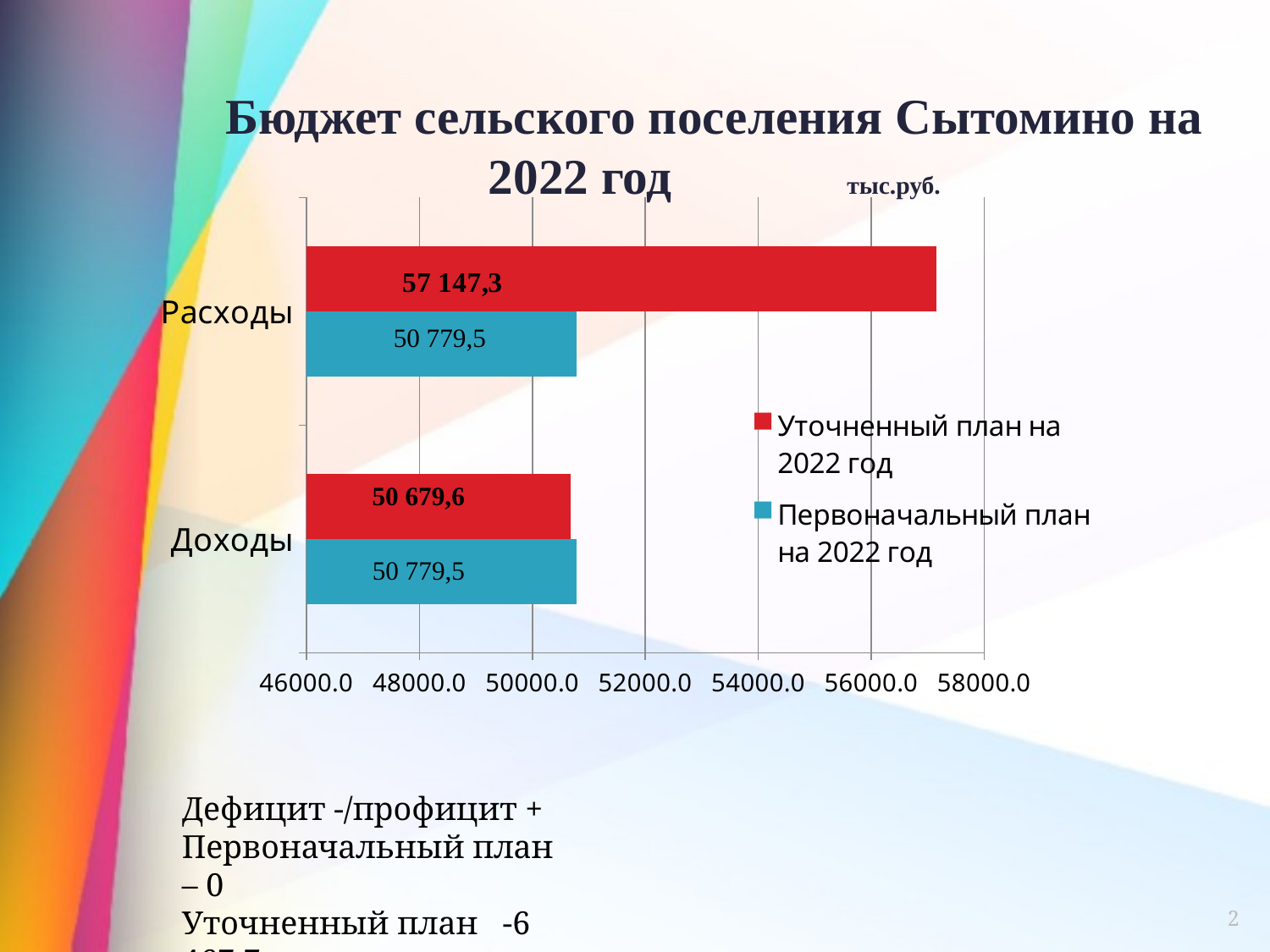
What is the difference between Уточненный план and Первоначальный план for Расходы? 6 367,8 What is the difference between Уточненный план for Расходы and Уточненный план for Доходы? 6 467,7 What is the value of Первоначальный план на 2022 год for Доходы? 50 779,5 What is the value of Уточненный план на 2022 год for Расходы? 57 147,3 What is the value of Первоначальный план на 2022 год for Расходы? 50 779,5 What kind of chart is shown on the slide? Bar chart Which is larger for Расходы: Уточненный план на 2022 год or Первоначальный план на 2022 год? Уточненный план на 2022 год Is the value of Уточненный план на 2022 год for Расходы greater or less than 56000.0? greater What is the value of Уточненный план на 2022 год for Доходы? 50 679,6 Which bar has the highest value on the chart? Расходы, Уточненный план на 2022 год How many categories are shown on the chart? 2 How many series does the legend list? 2